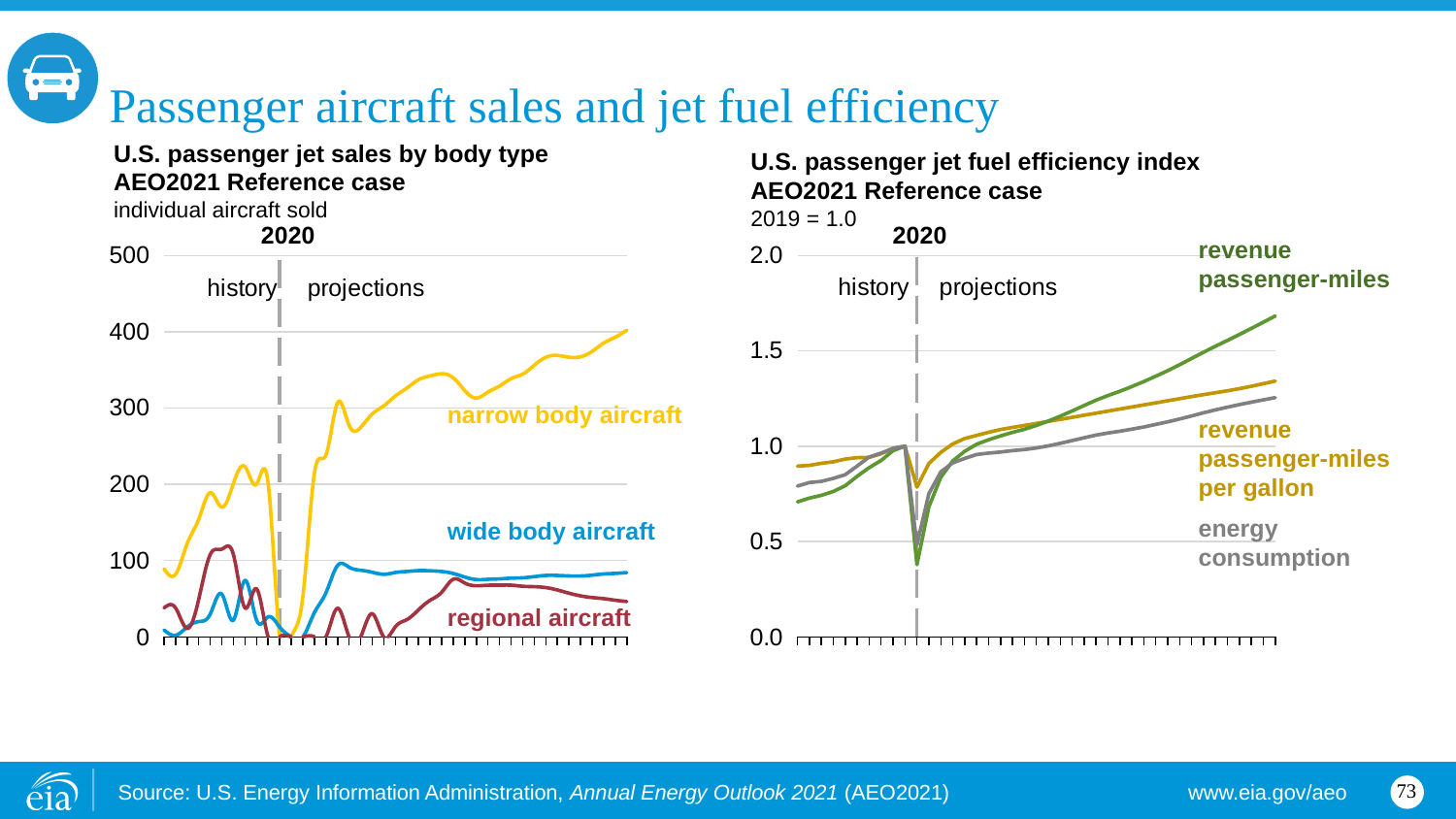
On the "U.S. passenger jet fuel efficiency index" chart, which series is highest at the end of the projection period? revenue passenger-miles What type of chart is the "U.S. passenger jet fuel efficiency index" chart on the right? line chart What year does the dashed vertical line separating history from projections mark on both charts? 2020 On the "U.S. passenger jet sales by body type" chart, is the value for narrow body aircraft at the end of the projections greater or less than 300? greater How many series are plotted on the "U.S. passenger jet sales by body type" chart? 3 What type of chart is the "U.S. passenger jet sales by body type" chart on the left? line chart On the "U.S. passenger jet fuel efficiency index" chart, do the values for energy consumption rise or fall over the projection period? rise How many series are plotted on the "U.S. passenger jet fuel efficiency index" chart? 3 On the "U.S. passenger jet sales by body type" chart, which series has the lowest value at the end of the projection period? regional aircraft On the "U.S. passenger jet fuel efficiency index" chart, is the value for revenue passenger-miles at the end of the projections greater or less than 1.5? greater On the "U.S. passenger jet sales by body type" chart, which series has the highest values at the end of the projection period? narrow body aircraft On the "U.S. passenger jet sales by body type" chart, is the value for wide body aircraft at the end of the projections greater or less than 100? less